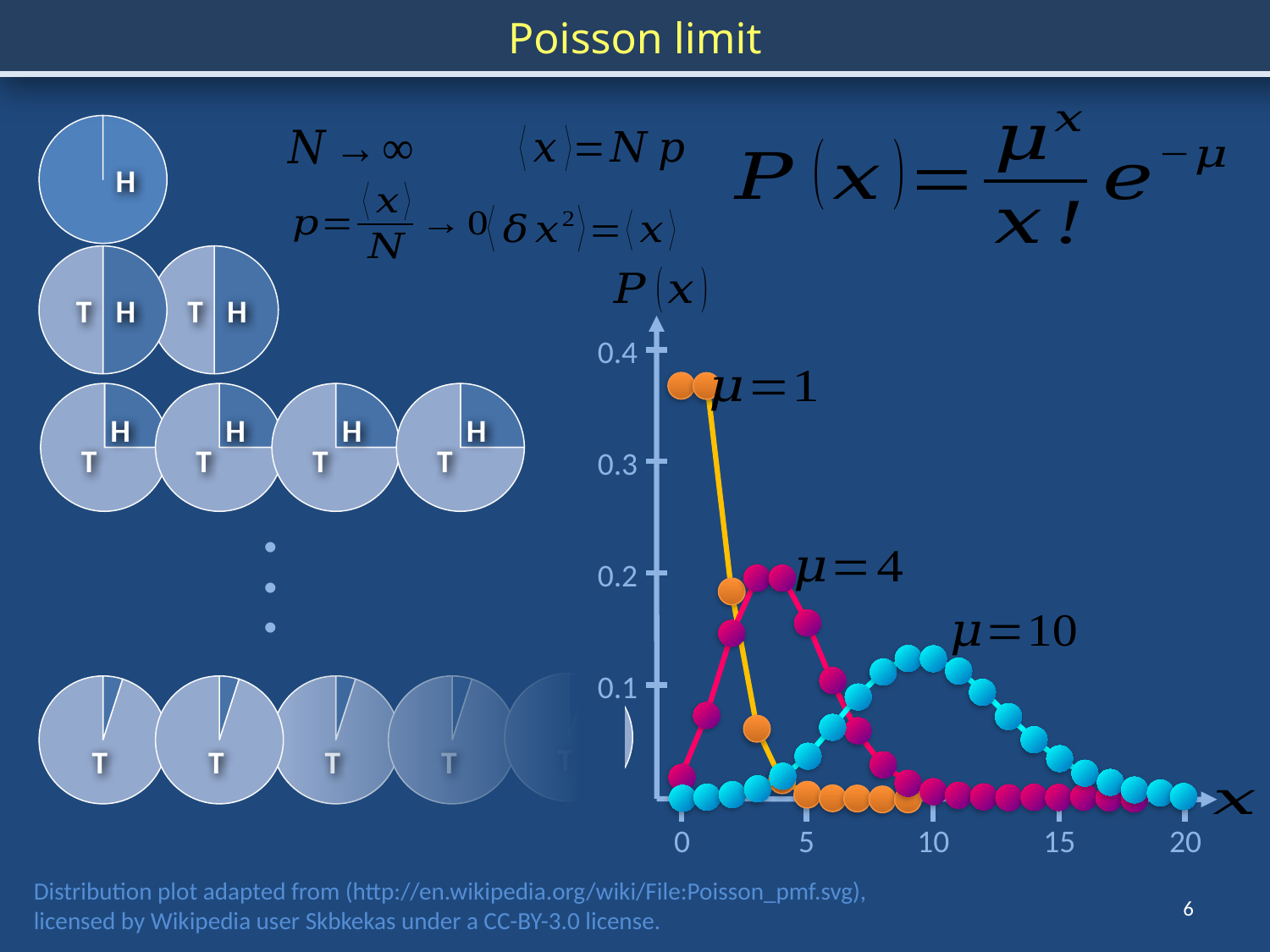
Is the value of the μ=1 series at x=3 greater or less than 0.1? less What is the largest value labelled on the x axis of the distribution chart? 20 Is the peak value of the μ=10 series greater or less than 0.2? less Which series has the lowest peak value of P(x)? μ=10 What kind of chart is the Poisson distribution plot? line chart Which series has the highest peak value of P(x)? μ=1 At x=10, which series has the larger value of P(x), μ=4 or μ=10? μ=10 What is the label on the vertical axis of the distribution chart? P(x) Is the value of the μ=10 series at x=10 greater or less than 0.1? greater How many series (values of μ) are plotted on the Poisson distribution chart? 3 Does the μ=1 series rise or fall as x increases from 1 to 5? fall